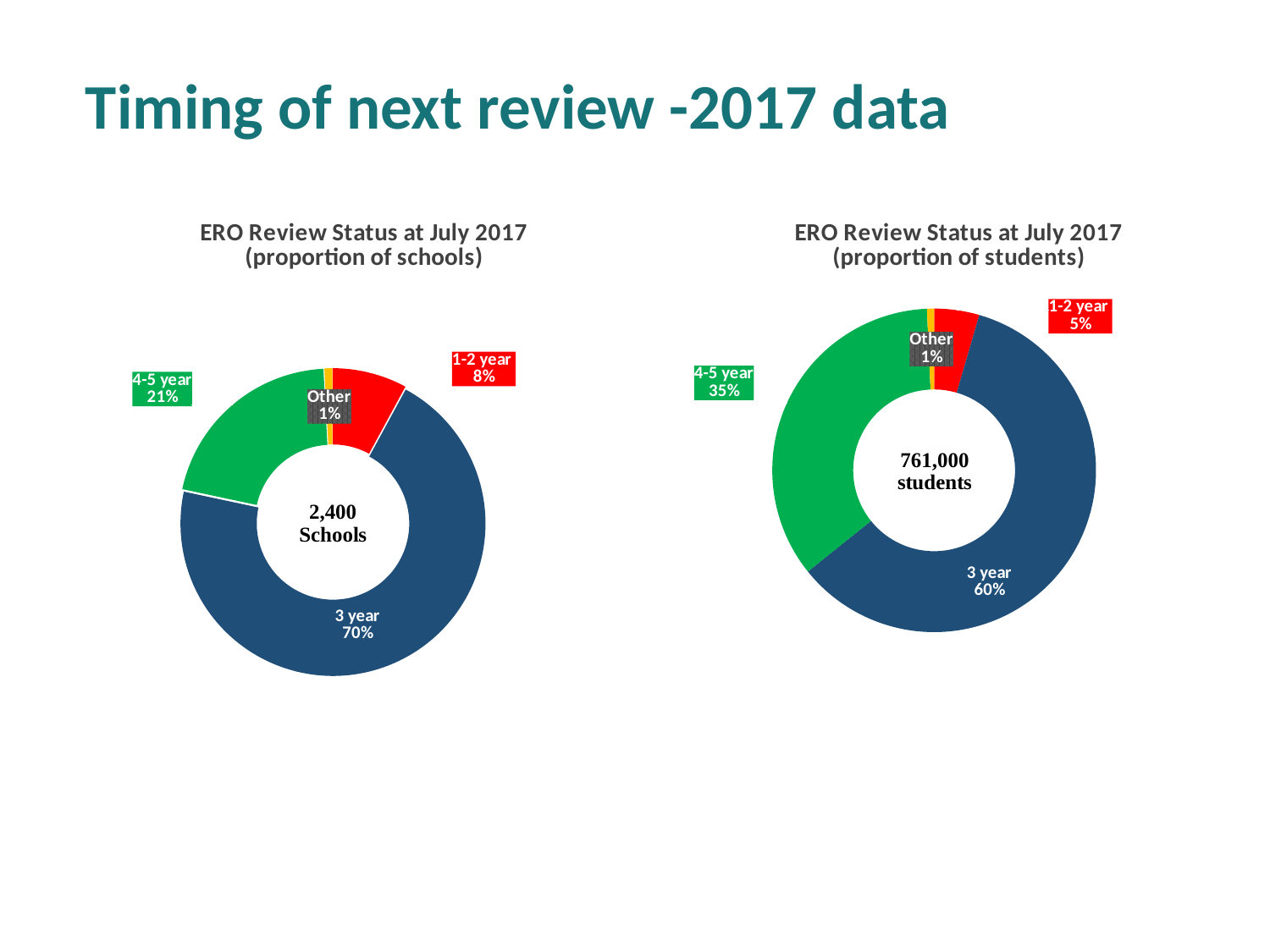
In the 'proportion of schools' chart, what is the difference between the 3 year share and the 4-5 year share? 49% How many categories are shown in the 'proportion of students' chart? 4 What total number is shown in the centre of the 'proportion of schools' chart? 2,400 Schools What type of chart is the 'proportion of schools' chart? Doughnut chart In the 'proportion of students' chart, which category has the largest share? 3 year In the 'proportion of students' chart, what is the difference between the 4-5 year share and the 1-2 year share? 30% In the 'proportion of schools' chart, what share is labelled 1-2 year? 8% Which is larger: the 1-2 year share in the 'proportion of schools' chart or the 1-2 year share in the 'proportion of students' chart? proportion of schools In the 'proportion of schools' chart, which category has the smallest share? Other In the 'proportion of schools' chart, what share of schools have a 3 year review status? 70% What total number is shown in the centre of the 'proportion of students' chart? 761,000 students In the 'proportion of students' chart, what share of students are in the 4-5 year category? 35%